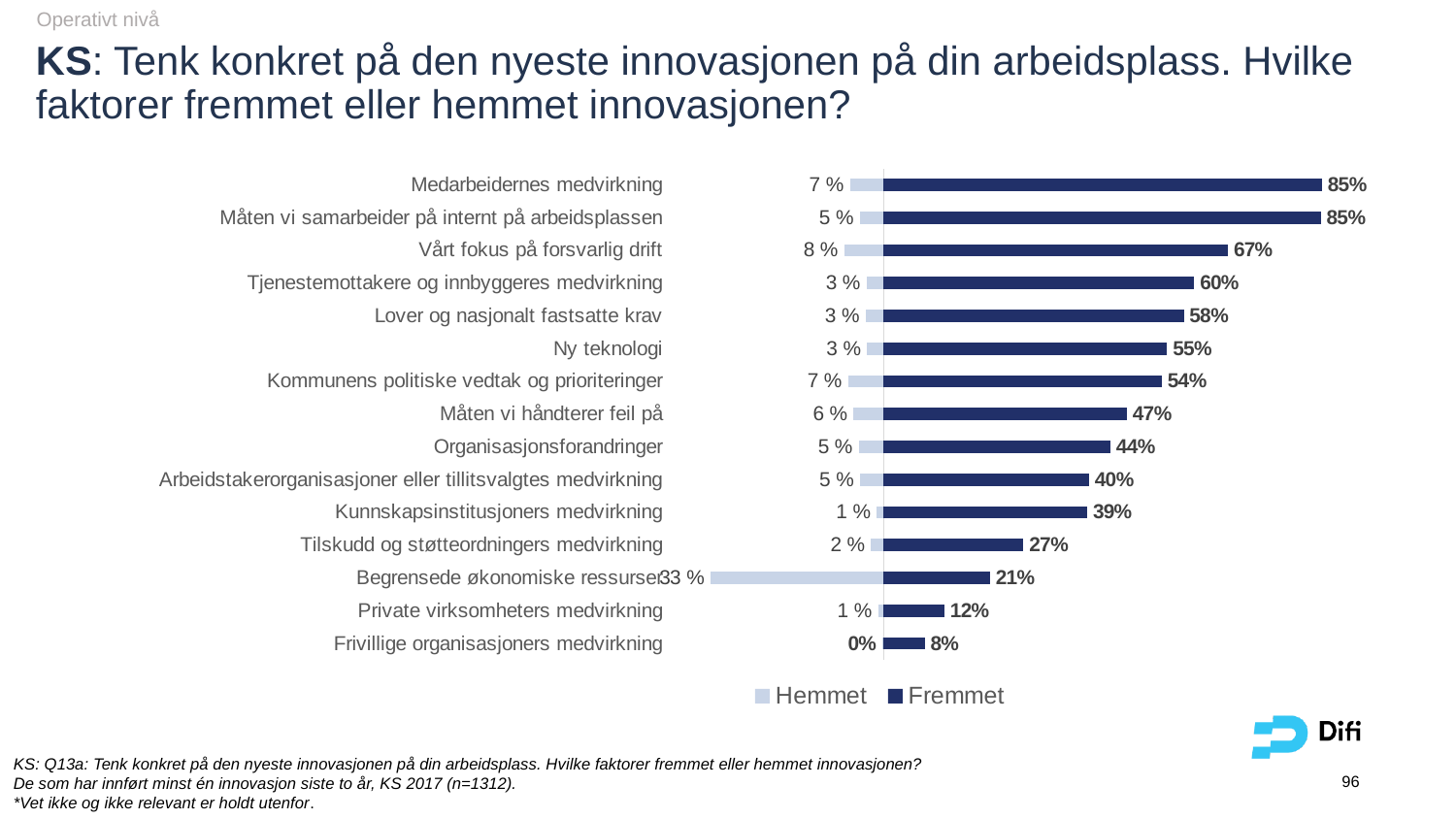
What kind of chart is shown on the slide? Bar chart What is the Hemmet value for Begrensede økonomiske ressurser? 33 % How many categories are shown in the chart? 15 What is the Fremmet value for Tilskudd og støtteordningers medvirkning? 27% What is the highest Fremmet value shown in the chart? 85% How many series does the legend list? 2 Which category has the lowest Fremmet value? Frivillige organisasjoners medvirkning Which category has the highest Hemmet value? Begrensede økonomiske ressurser What is the difference between the Fremmet and Hemmet values for Ny teknologi? 52 percentage points Which has a larger Fremmet value: Ny teknologi or Organisasjonsforandringer? Ny teknologi What is the Fremmet value for Vårt fokus på forsvarlig drift? 67% What is the Hemmet value for Måten vi håndterer feil på? 6 %